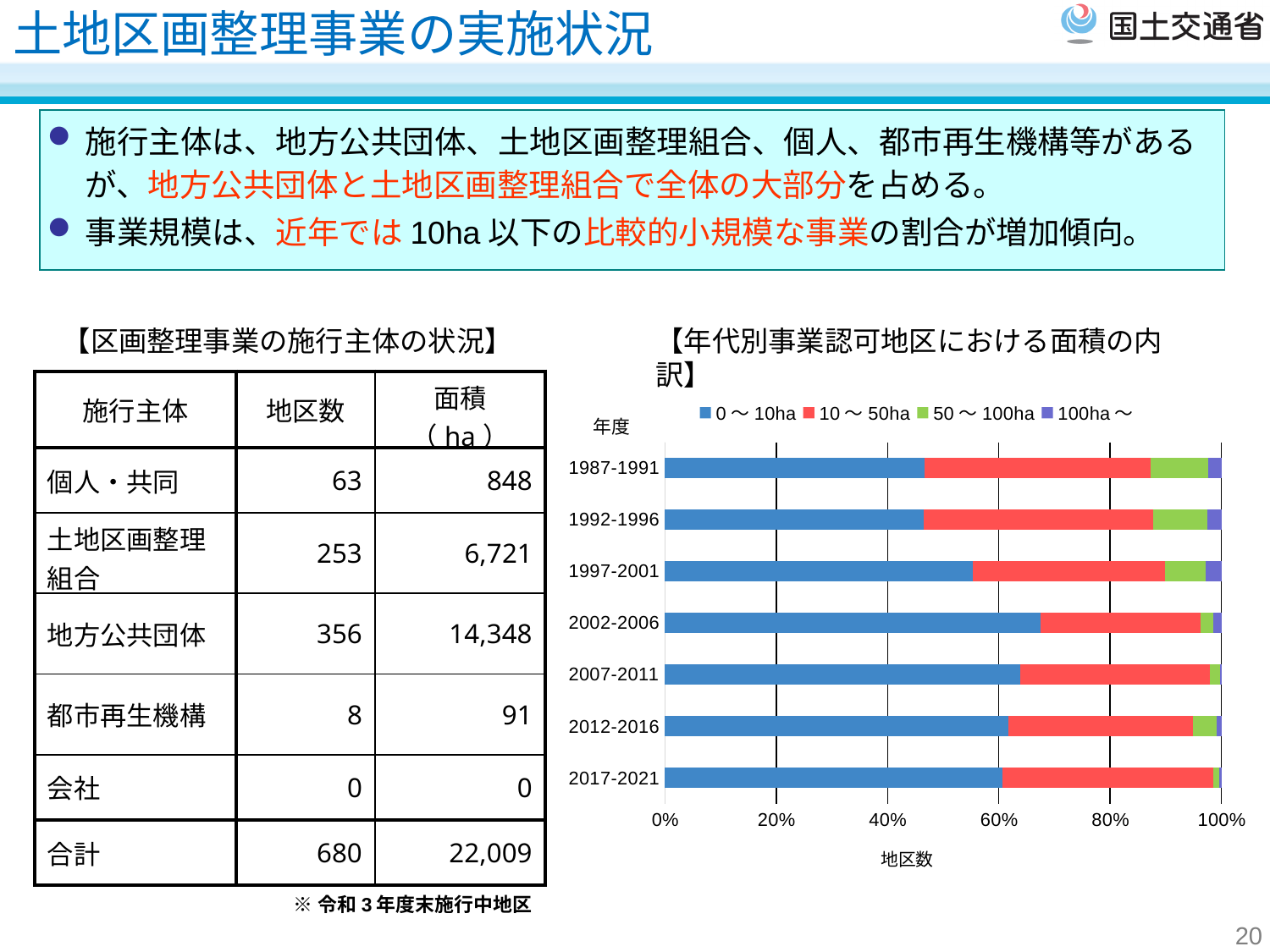
In the chart 【年代別事業認可地区における面積の内訳】, is the 0～10ha share for 2017-2021 greater or less than 40%? greater In the chart 【年代別事業認可地区における面積の内訳】, which category label appears at the top of the vertical axis? 1987-1991 In the chart 【年代別事業認可地区における面積の内訳】, what are the four legend entries? 0～10ha, 10～50ha, 50～100ha, 100ha～ How many series does the legend of the chart 【年代別事業認可地区における面積の内訳】 list? 4 In the chart 【年代別事業認可地区における面積の内訳】, which has the larger 0～10ha share: 1987-1991 or 2002-2006? 2002-2006 How many year-range categories are plotted in the chart 【年代別事業認可地区における面積の内訳】? 7 In the chart 【年代別事業認可地区における面積の内訳】, is the 0～10ha share for 1987-1991 greater or less than 60%? less In the chart 【年代別事業認可地区における面積の内訳】, is the 0～10ha share for 1997-2001 greater or less than 40%? greater What kind of chart is shown under the title 【年代別事業認可地区における面積の内訳】? bar chart In the chart 【年代別事業認可地区における面積の内訳】, which has the larger 50～100ha share: 1987-1991 or 2017-2021? 1987-1991